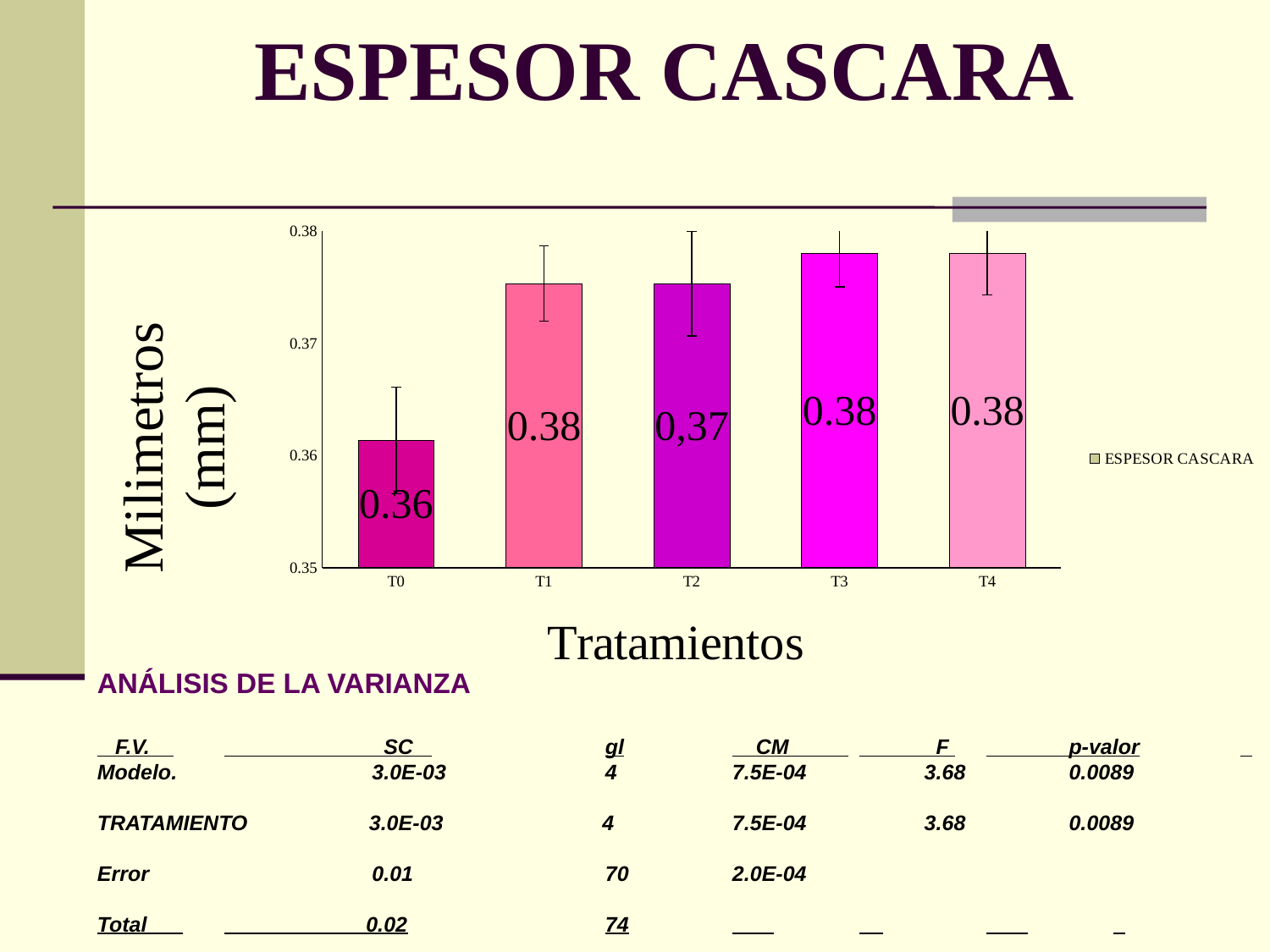
What is the value shown for T3? 0.38 How many series does the legend list? 1 Which is larger, the value for T0 or the value for T3? T3 How many treatments are shown on the x axis? 5 What is the value shown for T0? 0.36 Is the value for T3 greater or less than 0.37? greater Is the value for T0 greater or less than 0.37? less What is the value shown for T2? 0,37 What kind of chart is shown on the slide? bar chart What is the label of the y axis? Milimetros (mm) Which treatment has the lowest bar? T0 What is the difference between the labelled values for T3 and T0? 0.02